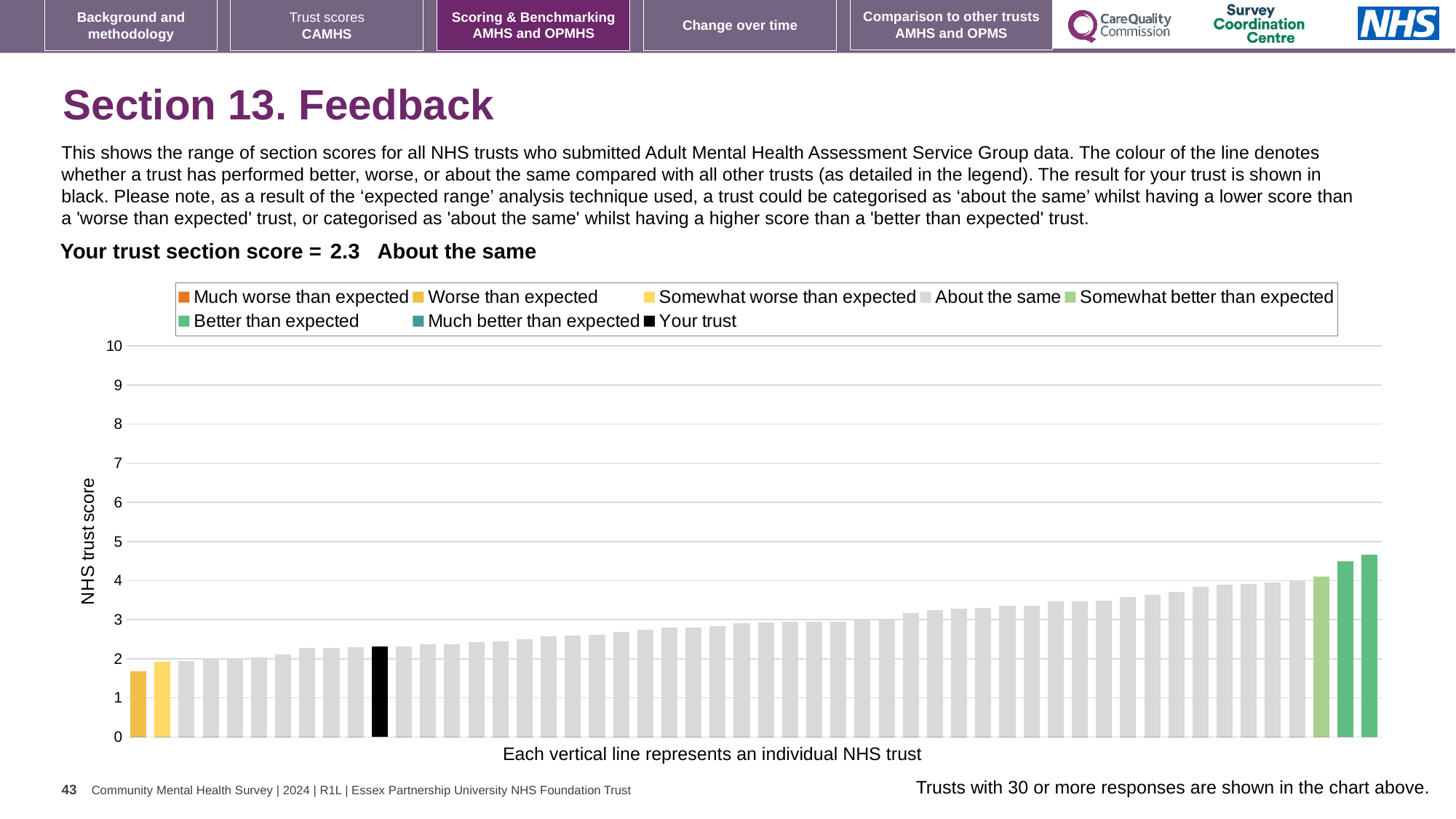
Is the value of the tallest bar in the chart greater or less than 4? greater What kind of chart is shown on the slide? bar chart Which category does your trust's section score fall into according to the slide? About the same Is the value of the black 'Your trust' bar greater or less than 3? less What is the section score for your trust shown on the slide? 2.3 Is the value of the black 'Your trust' bar greater or less than 2? greater Do the bar values rise or fall from left to right along the x axis? rise Which is larger, the leftmost bar or the rightmost bar? the rightmost bar What is the label on the y axis of the chart? NHS trust score How many entries does the chart legend list? 8